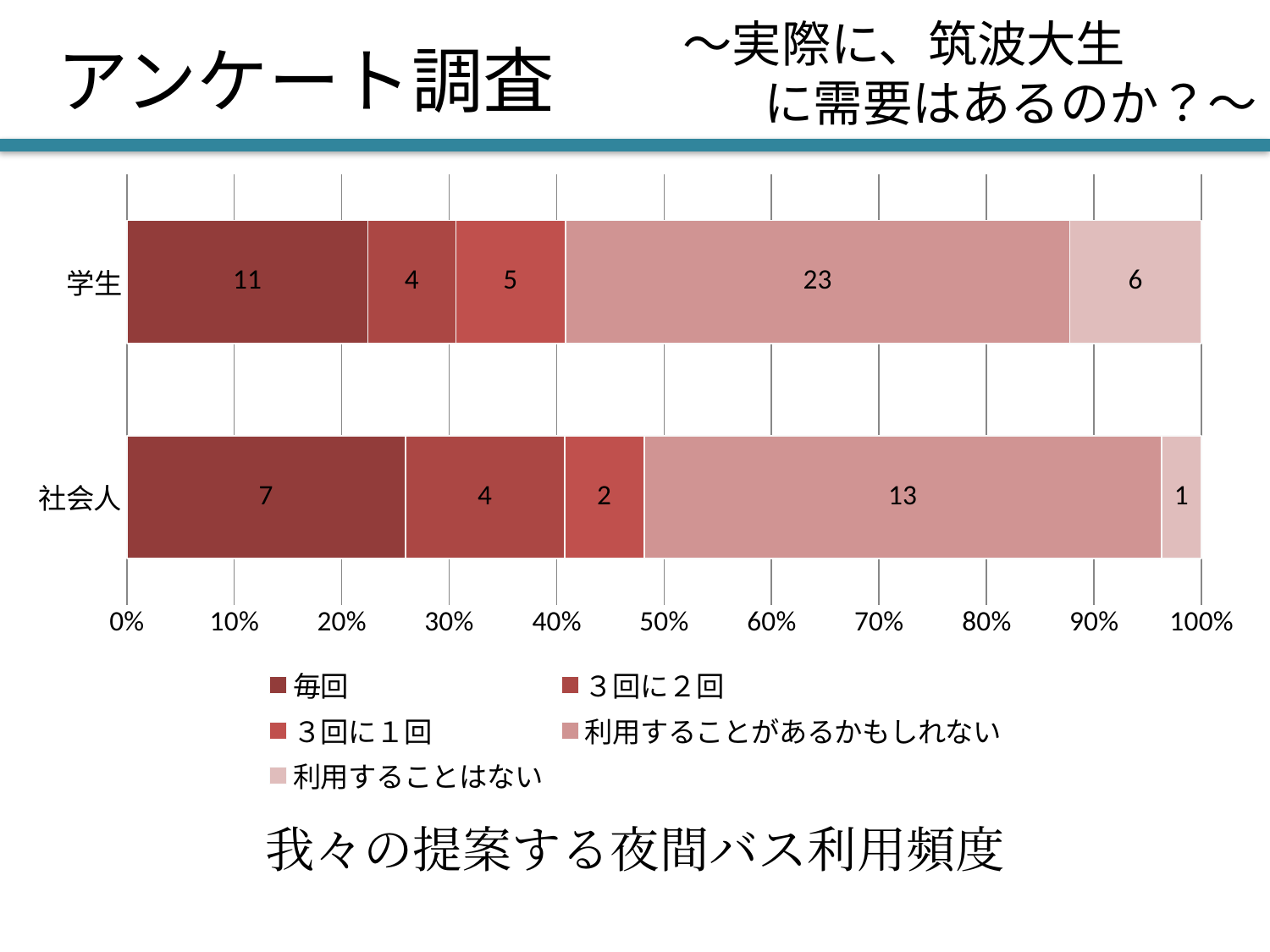
What kind of chart is shown on the slide? stacked bar chart What is the value for 毎回 in the 学生 bar? 11 How many series does the legend list? 5 What is the value for ３回に１回 in the 社会人 bar? 2 What is the total of all segments in the 学生 bar? 49 What is the value for 利用することがあるかもしれない in the 社会人 bar? 13 Which series has the largest value in the 学生 bar? 利用することがあるかもしれない Which series has the smallest value in the 社会人 bar? 利用することはない What is the total of all segments in the 社会人 bar? 27 What is the difference between the 毎回 values for 学生 and 社会人? 4 What is the value for 利用することはない in the 学生 bar? 6 How many categories are plotted on the chart? 2